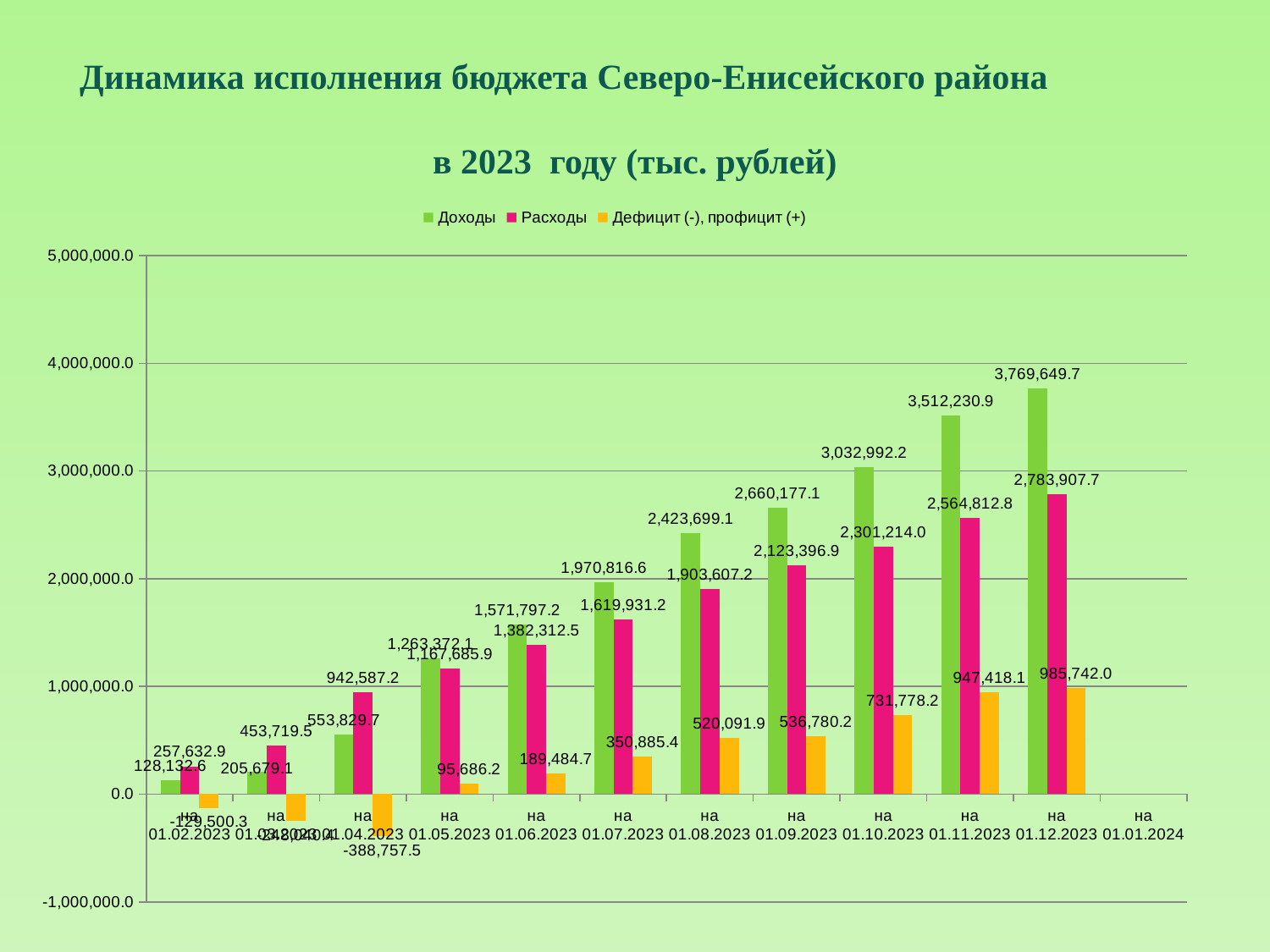
What kind of chart is shown on the slide? bar chart On which date is the Расходы series lowest? на 01.02.2023 On which date does the Доходы series reach its highest value? на 01.12.2023 Is the value of Расходы на 01.09.2023 greater or less than 2,000,000.0? greater Which is larger на 01.04.2023: Доходы or Расходы? Расходы What is the value of the Дефицит (-), профицит (+) series на 01.04.2023? -388,757.5 What is the value of Доходы на 01.12.2023? 3,769,649.7 How many series does the legend list? 3 Does the Доходы series rise or fall from 01.02.2023 to 01.12.2023? rise What is the value of the Дефицит (-), профицит (+) series на 01.10.2023? 731,778.2 What is the value of Расходы на 01.07.2023? 1,619,931.2 What is the difference between Доходы and Расходы на 01.12.2023? 985,742.0